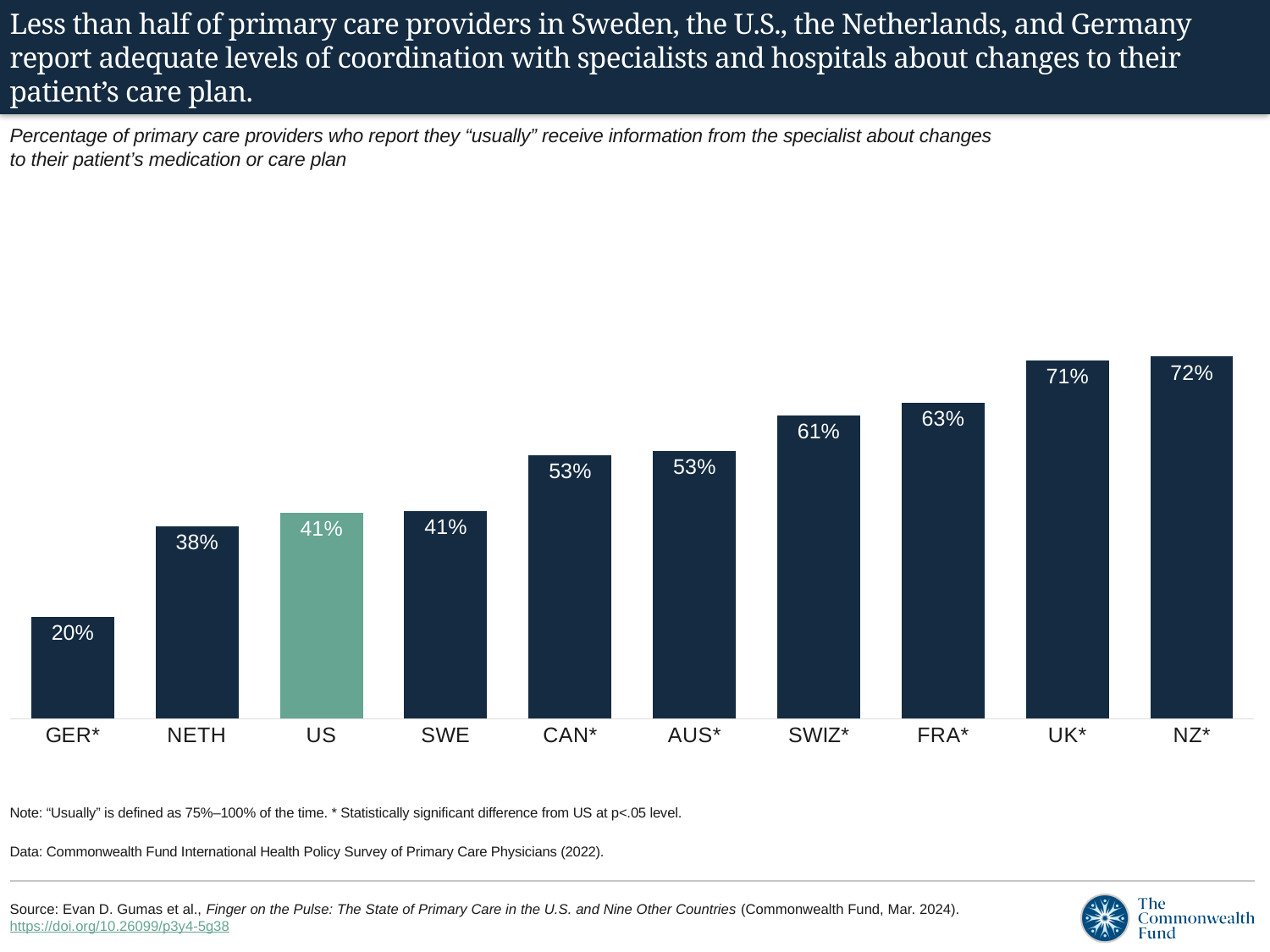
What type of chart is shown on the slide? Bar chart What is the value shown for FRA*? 63% What is the difference between the values for SWIZ* and NETH? 23 percentage points Which country's bar is shown in a different colour (green) from the others? US Which has a higher value, UK* or FRA*? UK* Which has a higher value, NETH or SWE? SWE What percentage of primary care providers in Germany (GER*) report they usually receive information from the specialist about changes to their patient's medication or care plan? 20% What is the difference between the values for NZ* and GER*? 52 percentage points Which country has the highest percentage of primary care providers who usually receive information from the specialist? NZ* How many countries are shown on the chart? 10 Which country has the lowest value on the chart? GER* What is the value shown for the US? 41%